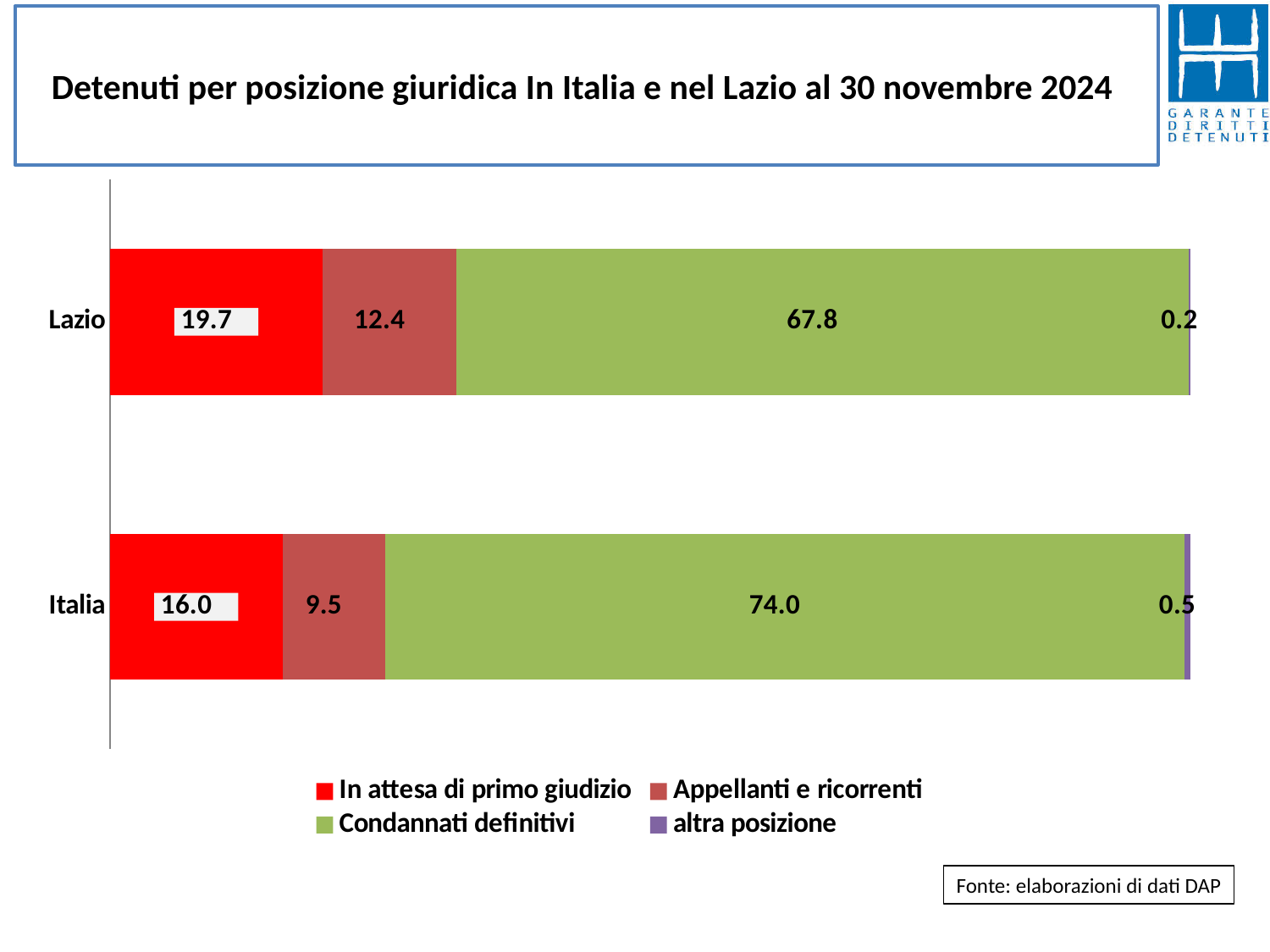
How many categories (bars) does the chart show? 2 What is the total of the stacked bar for Italia? 100.0 What is the value for "Appellanti e ricorrenti" for Lazio? 12.4 What is the value for "Condannati definitivi" for Italia? 74.0 What is the difference between the "Condannati definitivi" values for Italia and Lazio? 6.2 Which is larger, the "Appellanti e ricorrenti" value for Lazio or for Italia? Lazio Which series has the smallest value for Italia? altra posizione Which series has the largest value for Lazio? Condannati definitivi What is the value for "altra posizione" for Italia? 0.5 What kind of chart is shown on the slide? Stacked bar chart What is the value for "In attesa di primo giudizio" for Lazio? 19.7 How many series does the legend list? 4